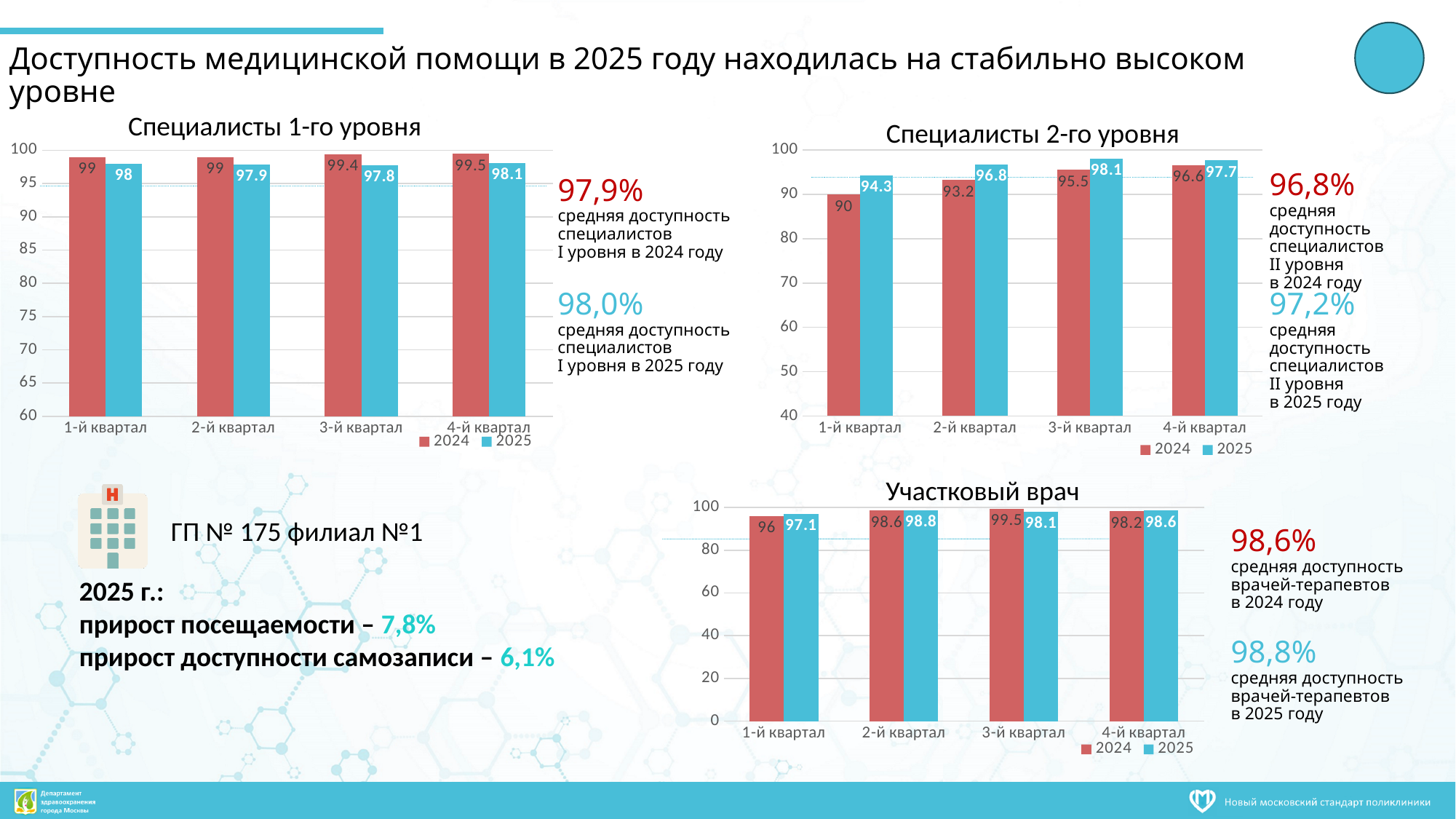
In the chart 'Специалисты 2-го уровня', which quarter has the lowest value for 2024? 1-й квартал In the chart 'Участковый врач', what is the value for 2025 in 2-й квартал? 98.8 In the chart 'Специалисты 1-го уровня', is the 2024 value for 4-й квартал greater or less than 95? greater What type of chart is 'Специалисты 2-го уровня'? bar chart In the chart 'Специалисты 1-го уровня', what is the value for 2025 in 3-й квартал? 97.8 In the chart 'Специалисты 2-го уровня', what is the difference between the 2025 and 2024 values in 1-й квартал? 4.3 In the chart 'Специалисты 2-го уровня', which quarter has the highest value for 2025? 3-й квартал How many quarters are shown on the x axis of the chart 'Участковый врач'? 4 In the chart 'Специалисты 2-го уровня', do the 2024 values rise or fall from 1-й квартал to 4-й квартал? rise How many series does the legend of the chart 'Специалисты 1-го уровня' list? 2 In the chart 'Специалисты 2-го уровня', what is the value for 2024 in 1-й квартал? 90 In the chart 'Участковый врач', which is larger in 3-й квартал: the 2024 value or the 2025 value? 2024